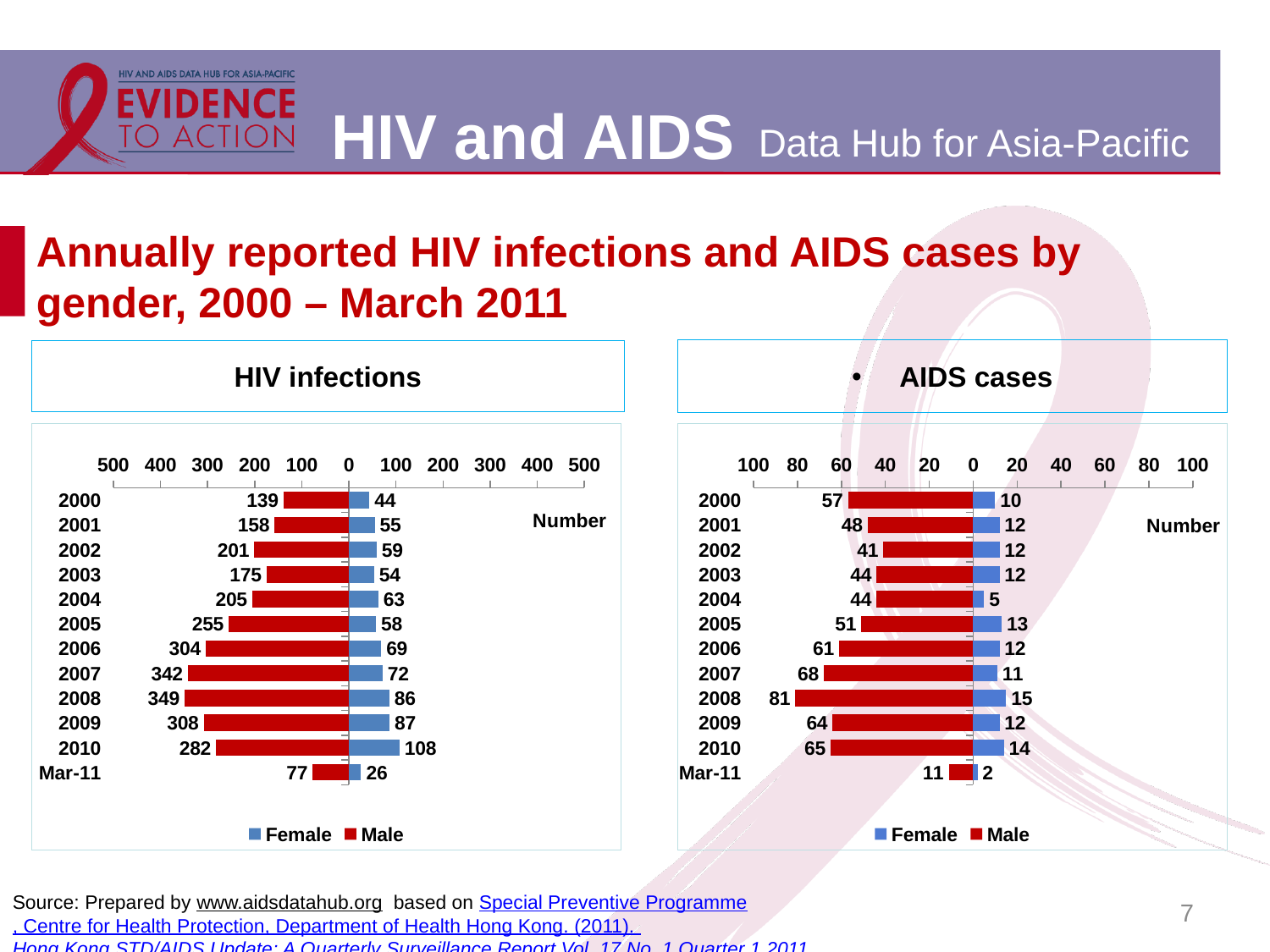
What type of chart is the HIV infections chart? Bar chart In the HIV infections chart, what is the difference between the Male and Female values in 2007? 270 How many series does the legend of the AIDS cases chart list? 2 In the HIV infections chart, what is the value for Male in 2008? 349 In the AIDS cases chart, what is the value for Male in 2007? 68 In the AIDS cases chart, which is larger in 2005: the Male value or the Female value? Male In the AIDS cases chart, what is the value for Female in 2004? 5 In the HIV infections chart, which year has the highest Male value? 2008 In the AIDS cases chart, which period has the lowest Female value? Mar-11 In the HIV infections chart, what is the total of Male and Female values in 2000? 183 How many time periods are shown on the HIV infections chart? 12 In the HIV infections chart, what is the value for Female in 2010? 108